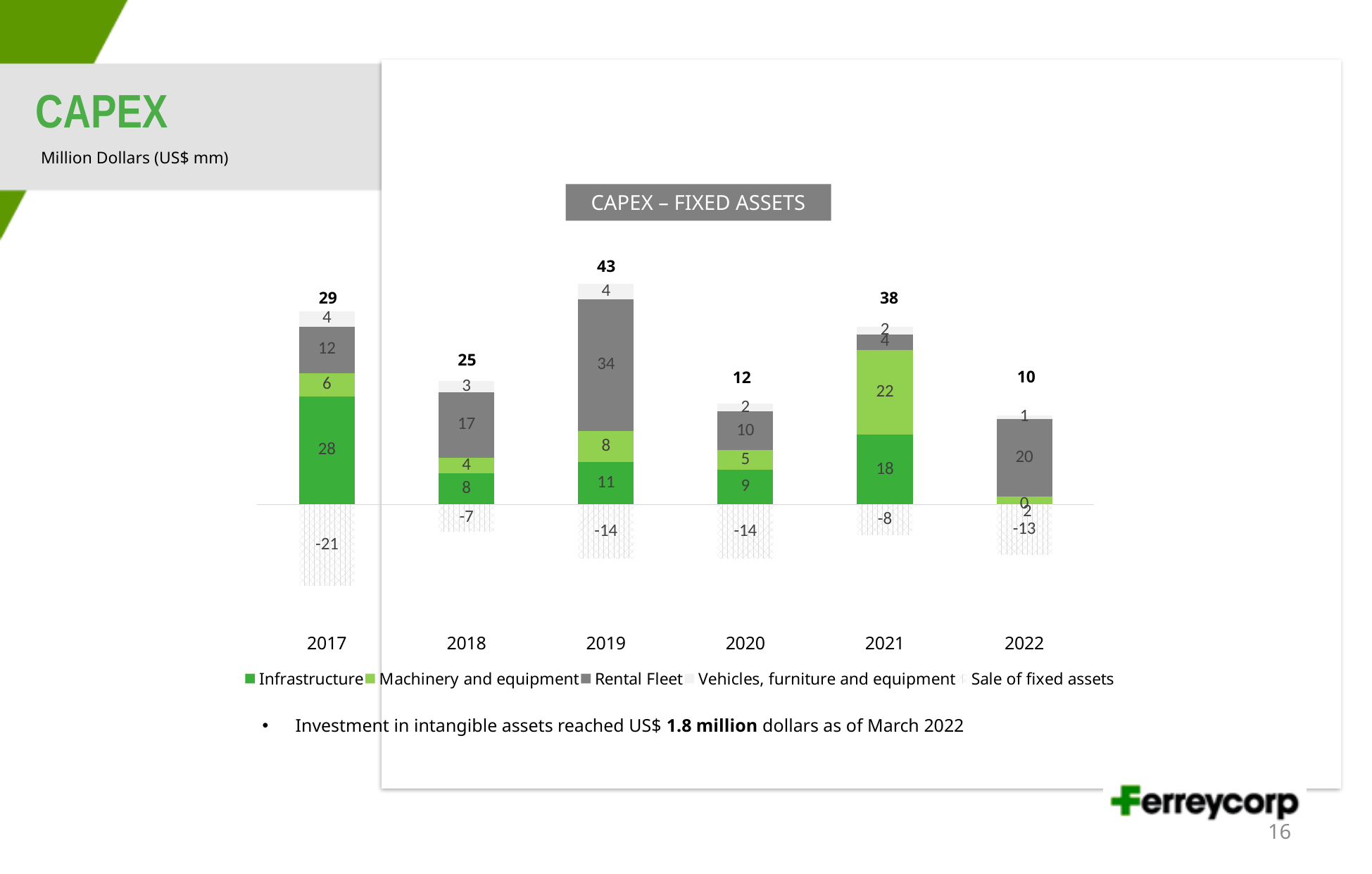
What is the total CAPEX – Fixed Assets value labelled for 2019? 43 How many years are shown on the x axis of the chart? 6 What is the Infrastructure value for 2017? 28 What is the Sale of fixed assets value for 2022? -13 What is the Rental Fleet value for 2019? 34 What type of chart is shown on the slide? Stacked bar chart What is the difference between the total CAPEX values for 2019 and 2020? 31 Which year has the lowest total CAPEX – Fixed Assets value? 2022 What is the Machinery and equipment value for 2021? 22 Which year has the highest total CAPEX – Fixed Assets value? 2019 Which is larger, the Rental Fleet value for 2018 or for 2022? 2022 How many series does the legend list? 5